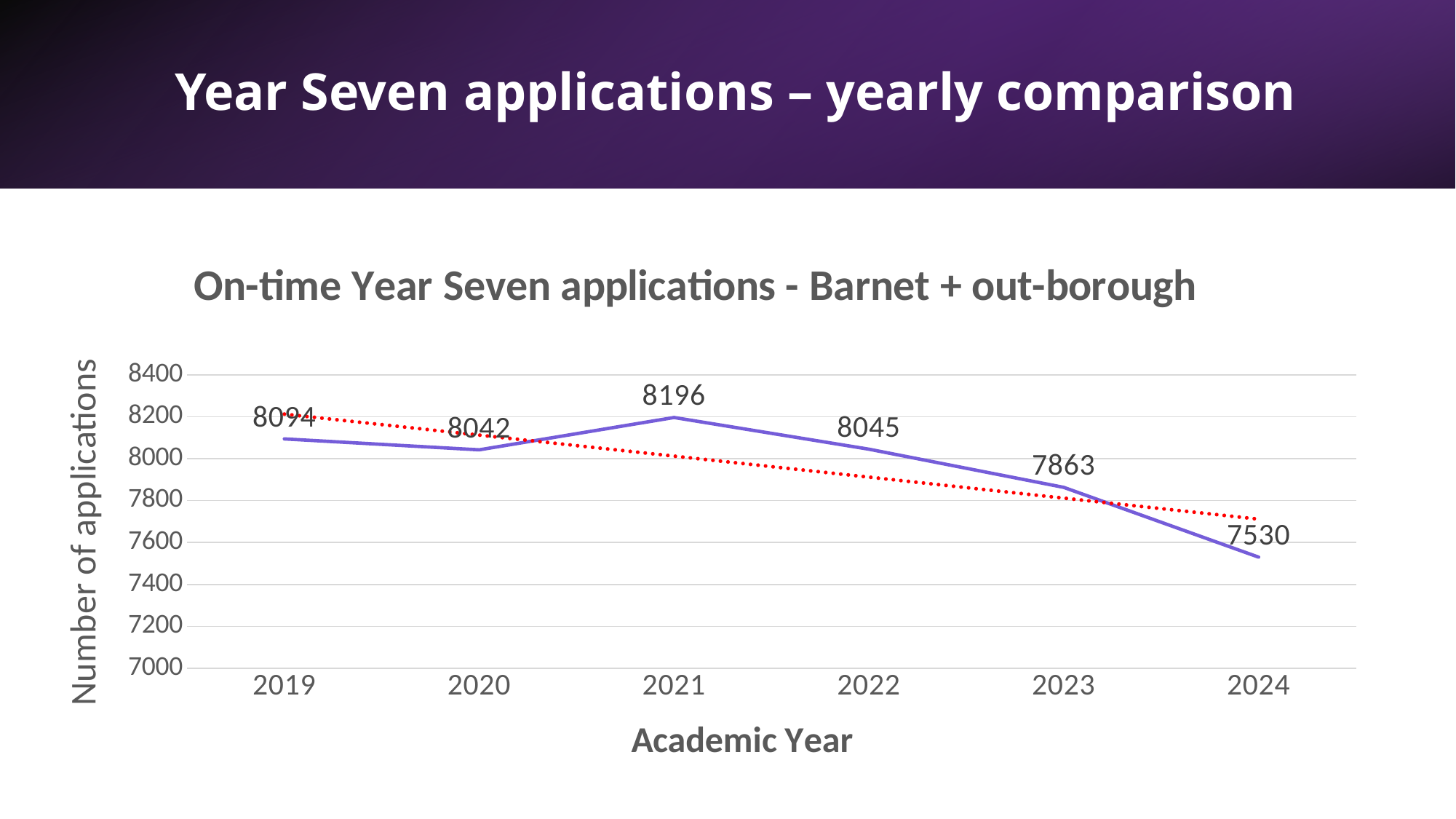
Is the value for 2024 greater or less than 7600? less What type of chart is shown on the slide? line chart What is the number of on-time Year Seven applications in 2024? 7530 What is the number of on-time Year Seven applications in 2021? 8196 What is the title of the chart? On-time Year Seven applications - Barnet + out-borough Which year had more applications, 2022 or 2023? 2022 How many academic years are plotted on the x axis? 6 What is the difference between the number of applications in 2021 and in 2024? 666 Which academic year has the lowest number of applications? 2024 Which academic year has the highest number of applications? 2021 What is the number of on-time Year Seven applications in 2023? 7863 What is the number of on-time Year Seven applications in 2020? 8042